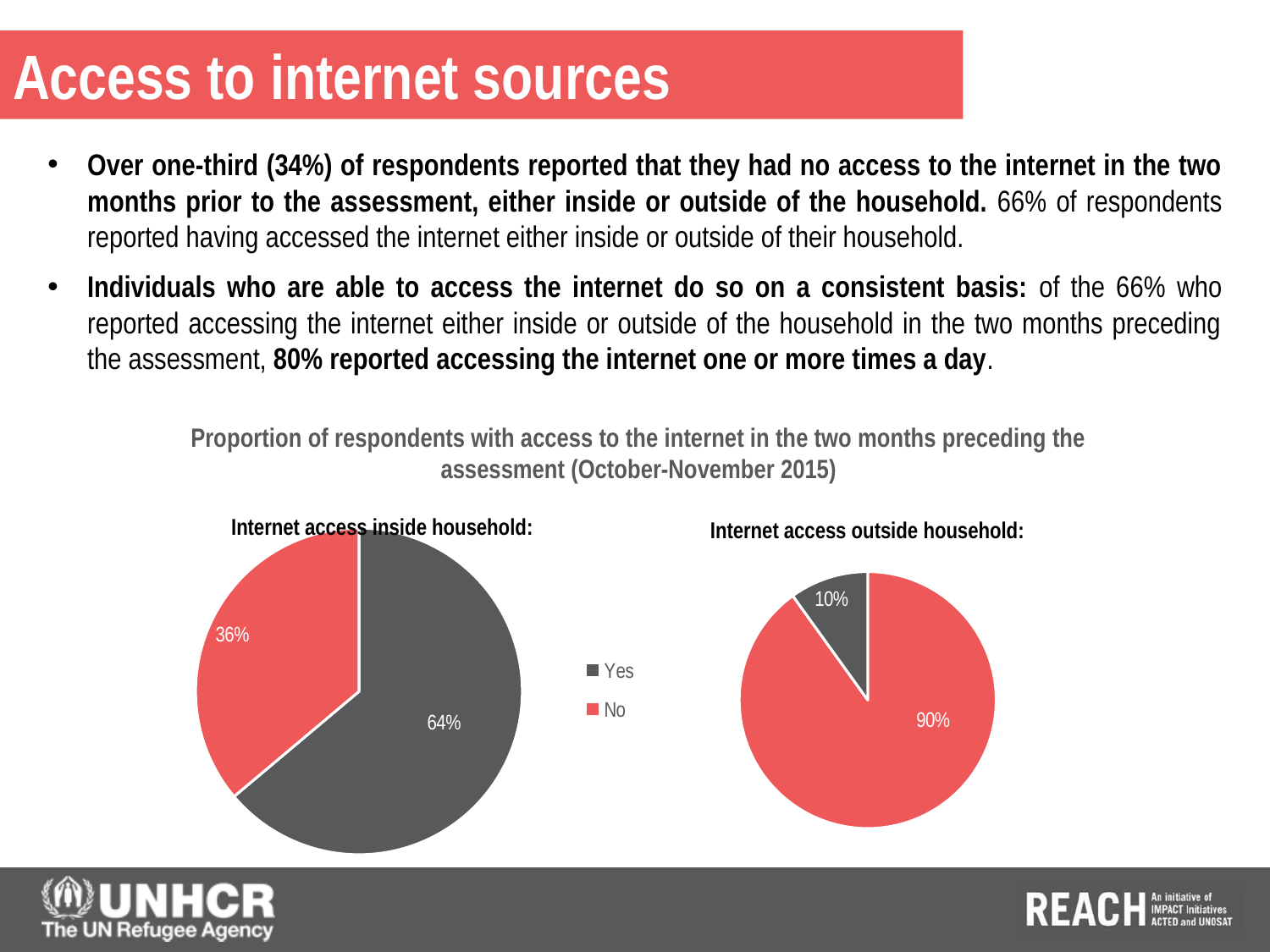
In the pie charts, which colour represents the 'No' response? Red In the 'Internet access outside household' pie chart, which response has the smaller share? Yes Is the Yes share larger in the 'Internet access inside household' chart or the 'Internet access outside household' chart? Internet access inside household In the 'Internet access inside household' pie chart, which response has the larger share? Yes What type of chart is used to show internet access inside and outside the household? Pie chart In the 'Internet access inside household' pie chart, what is the difference in percentage points between the Yes and No shares? 28 In the 'Internet access outside household' pie chart, what is the difference in percentage points between the No and Yes shares? 80 In the 'Internet access inside household' pie chart, what percentage of respondents answered Yes? 64% In the 'Internet access outside household' pie chart, what percentage of respondents answered No? 90% How many entries does the legend shared by the two pie charts list? 2 In the 'Internet access inside household' pie chart, what percentage of respondents answered No? 36% In the 'Internet access outside household' pie chart, what percentage of respondents answered Yes? 10%